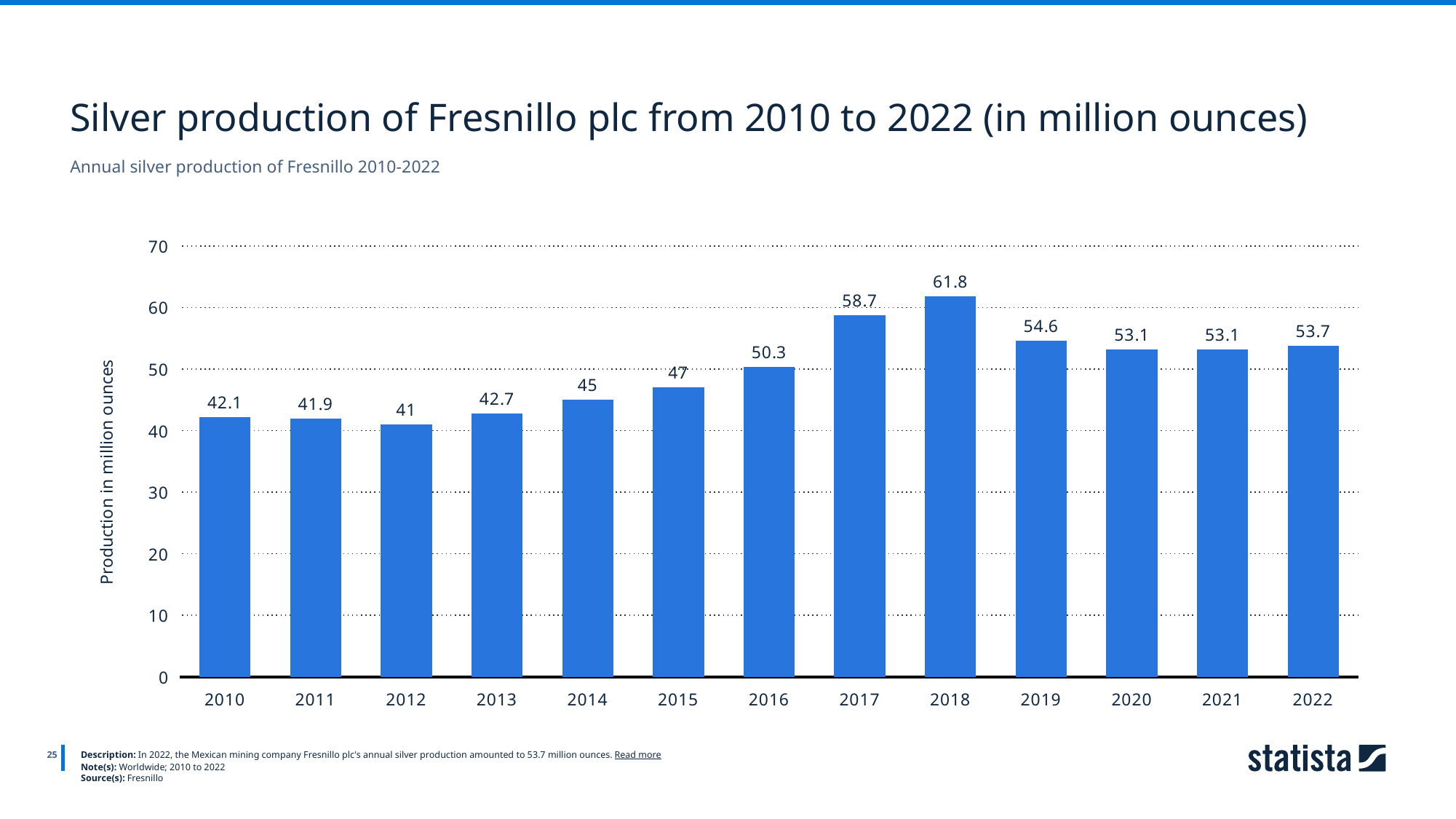
What was Fresnillo's silver production in 2022? 53.7 Which year had higher silver production, 2016 or 2019? 2019 What is the difference in silver production between 2018 and 2017? 3.1 How many years are shown on the x axis? 13 Which year had the lowest silver production? 2012 What was Fresnillo's silver production in 2012? 41 What was Fresnillo's silver production in 2018? 61.8 What is the difference in silver production between 2022 and 2010? 11.6 Which year had the highest silver production? 2018 Is the value for 2015 greater or less than 50? less What kind of chart is shown on the slide? Bar chart What is the label of the y axis? Production in million ounces